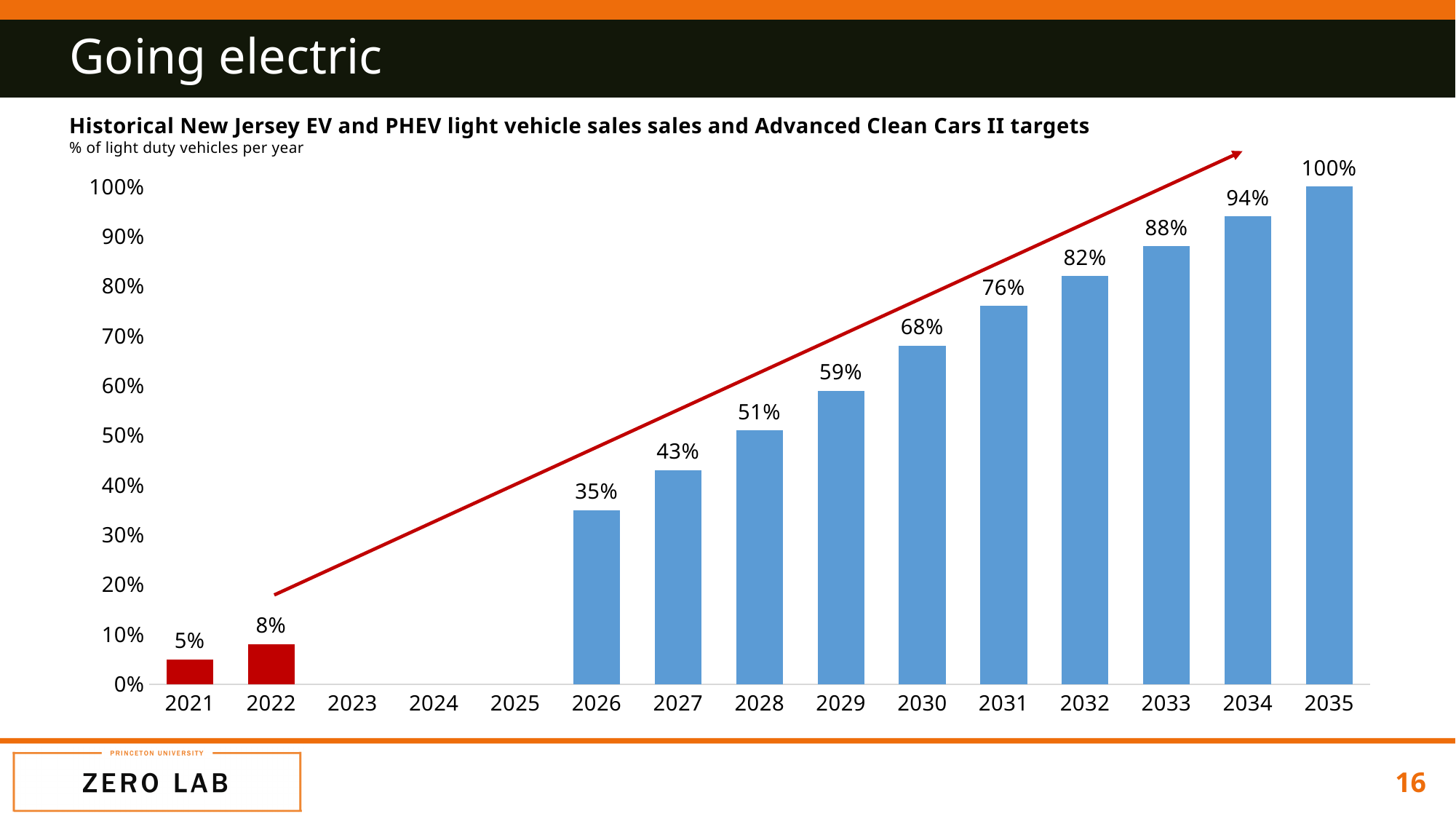
What is the value for 2022? 8% Which is larger, the value for 2028 or the value for 2029? 2029 Which year has the highest value? 2035 What is the difference between the values for 2035 and 2034? 6% What is the value for 2026? 35% What kind of chart is this? bar chart Do the values rise or fall from 2026 to 2035? rise Which year with a bar has the lowest value? 2021 What is the difference between the values for 2026 and 2022? 27% What is the unit described in the chart subtitle? % of light duty vehicles per year How many years on the x axis have a bar plotted? 12 What is the value for 2030? 68%